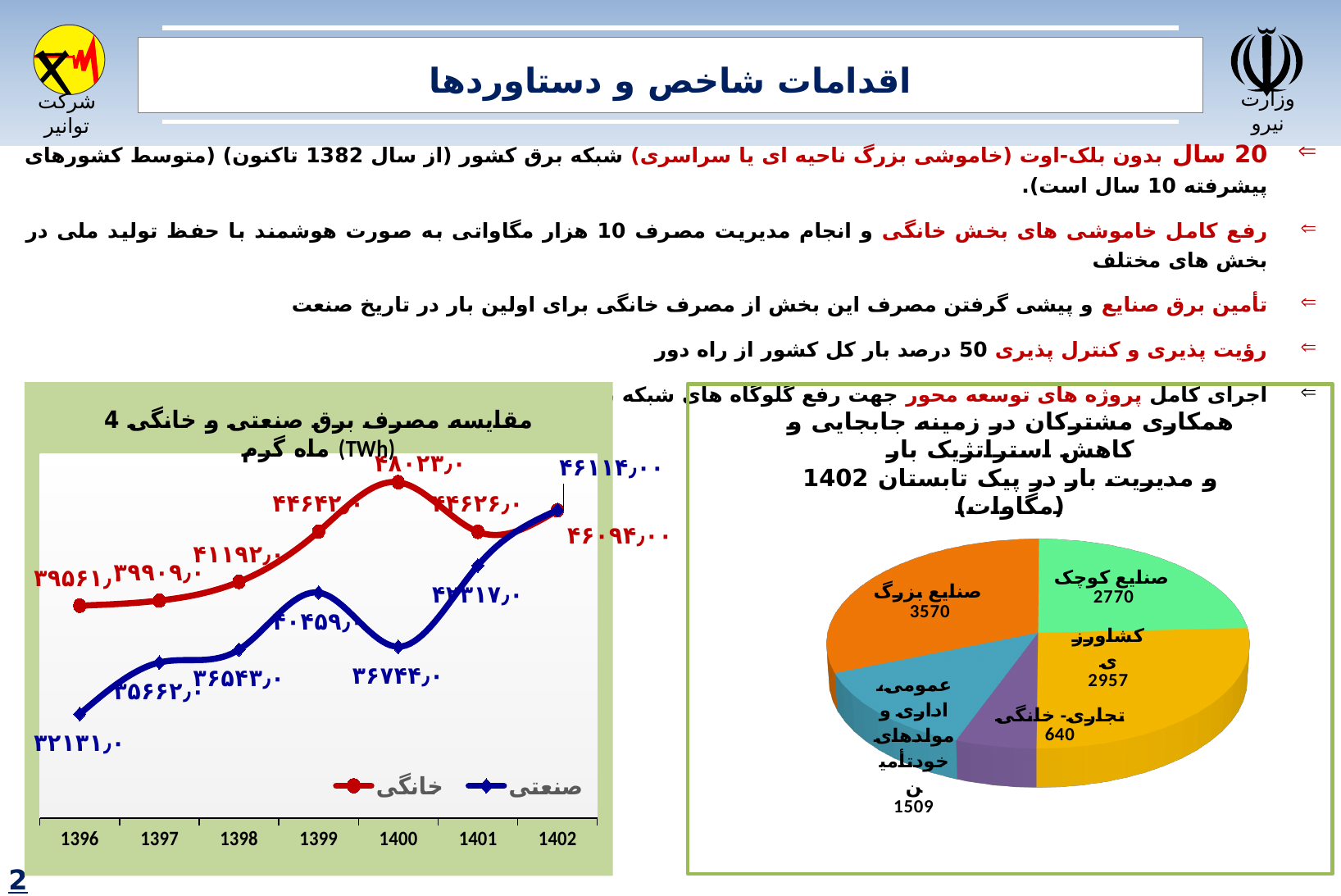
In the line chart on the left, what is the value of the خانگی series in 1400? ۴۸۰۲۳٫۰ What kind of chart is the chart on the left of the slide (مقایسه مصرف برق صنعتی و خانگی)? line chart In the pie chart on the right, what is the value for کشاورزی? 2957 How many series does the legend of the line chart on the left list? 2 In the line chart on the left, in which year is the صنعتی series at its lowest? 1396 In the pie chart on the right, which category has the largest value? صنایع بزرگ In the pie chart on the right, which category has the smallest value? تجاری- خانگی How many slices does the pie chart on the right have? 5 In the pie chart on the right, what is the difference between the values for صنایع بزرگ and صنایع کوچک? 800 In the line chart on the left, in which year is the خانگی series at its highest? 1400 How many years are shown on the x axis of the line chart on the left? 7 What kind of chart is the chart on the right of the slide (همکاری مشترکان ... پیک تابستان 1402)? pie chart